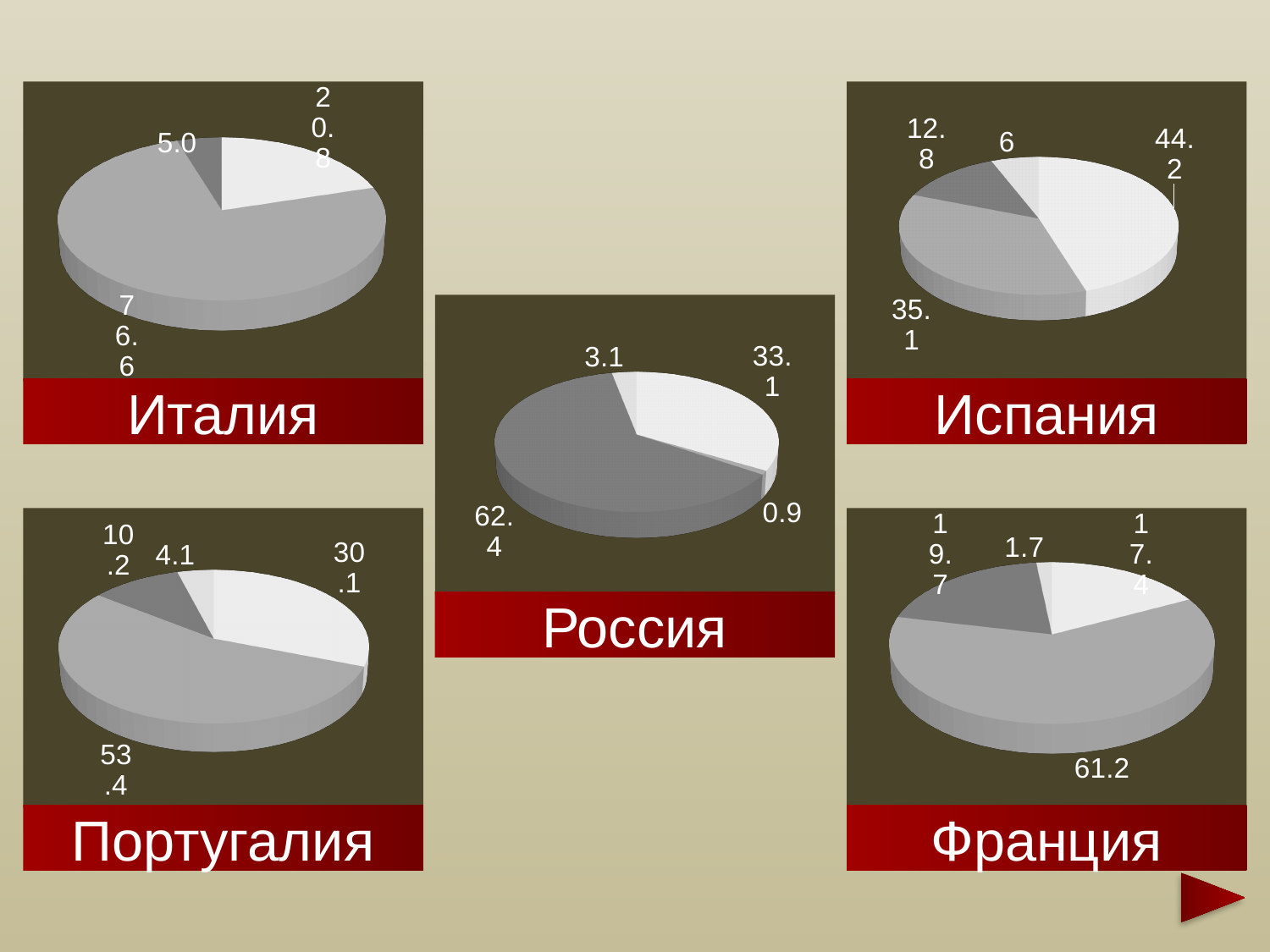
In the Россия chart, what is the value of the smallest slice? 0.9 In the Португалия chart, what is the value of the largest slice? 53.4 How many pie charts are on the slide? 5 In the Испания chart, what is the value of the largest slice? 44.2 How many slices does the Россия pie chart have? 4 Which is larger: the largest slice in the Россия chart (62.4) or the largest slice in the Франция chart (61.2)? Россия (62.4) In the Франция chart, what is the value of the largest slice? 61.2 In the Италия chart, what is the value of the smallest slice? 5.0 In the Испания chart, what is the value of the smallest slice? 6 What type of charts are shown on the slide? Pie charts